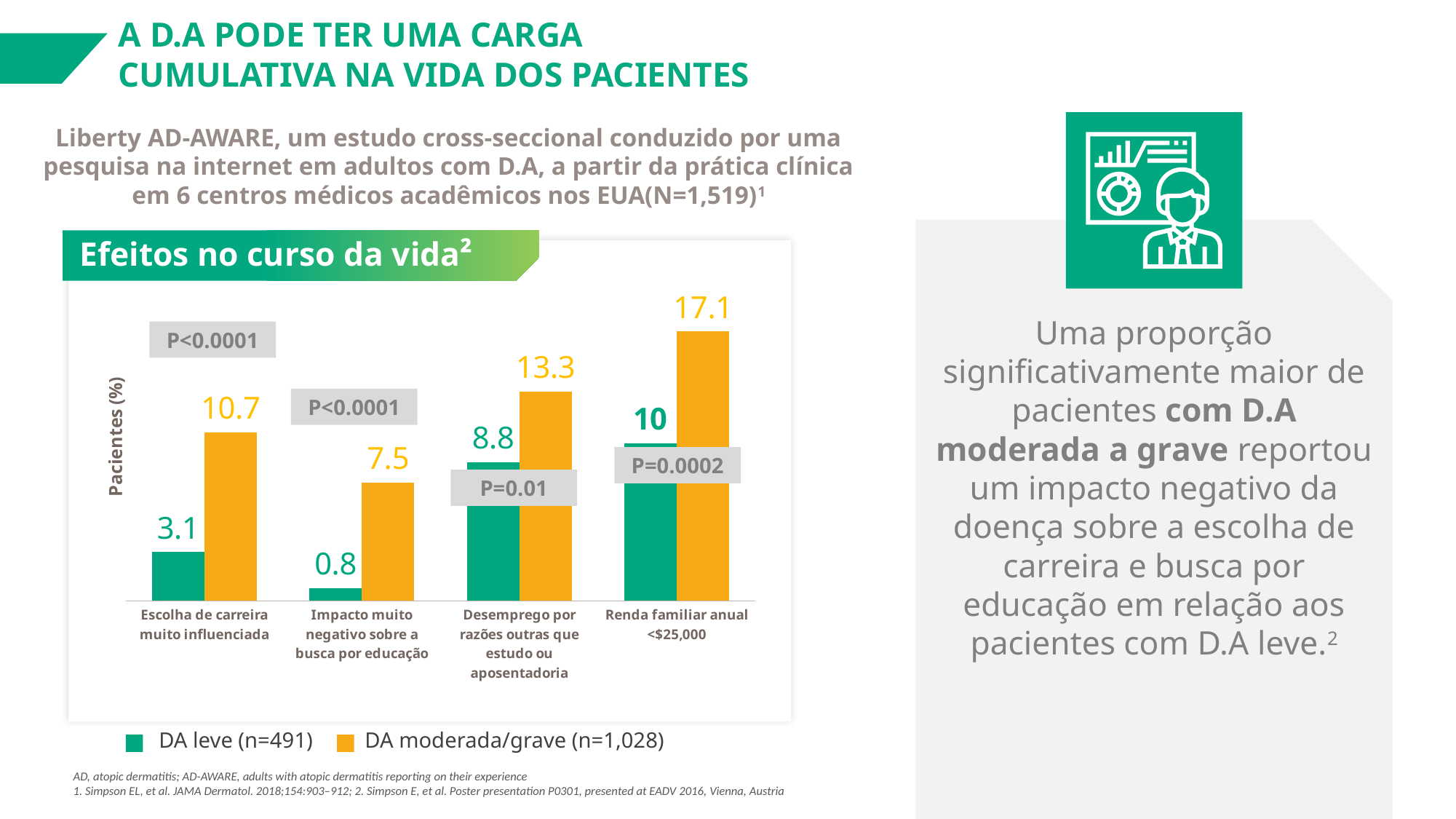
What type of chart is shown on the slide? Bar chart What is the value for DA leve in the 'Desemprego por razões outras que estudo ou aposentadoria' category? 8.8 What is the difference between DA moderada/grave and DA leve in the 'Escolha de carreira muito influenciada' category? 7.6 What is the value for DA moderada/grave in the 'Renda familiar anual <$25,000' category? 17.1 In the 'Renda familiar anual <$25,000' category, which series has the larger value, DA leve or DA moderada/grave? DA moderada/grave Which category has the lowest value for DA leve? Impacto muito negativo sobre a busca por educação How many categories are shown on the x axis of the chart? 4 Which category has the highest value for DA moderada/grave? Renda familiar anual <$25,000 How many series does the chart legend list? 2 What is the title of the chart? Efeitos no curso da vida What is the value for DA moderada/grave in the 'Escolha de carreira muito influenciada' category? 10.7 What is the value for DA leve in the 'Impacto muito negativo sobre a busca por educação' category? 0.8